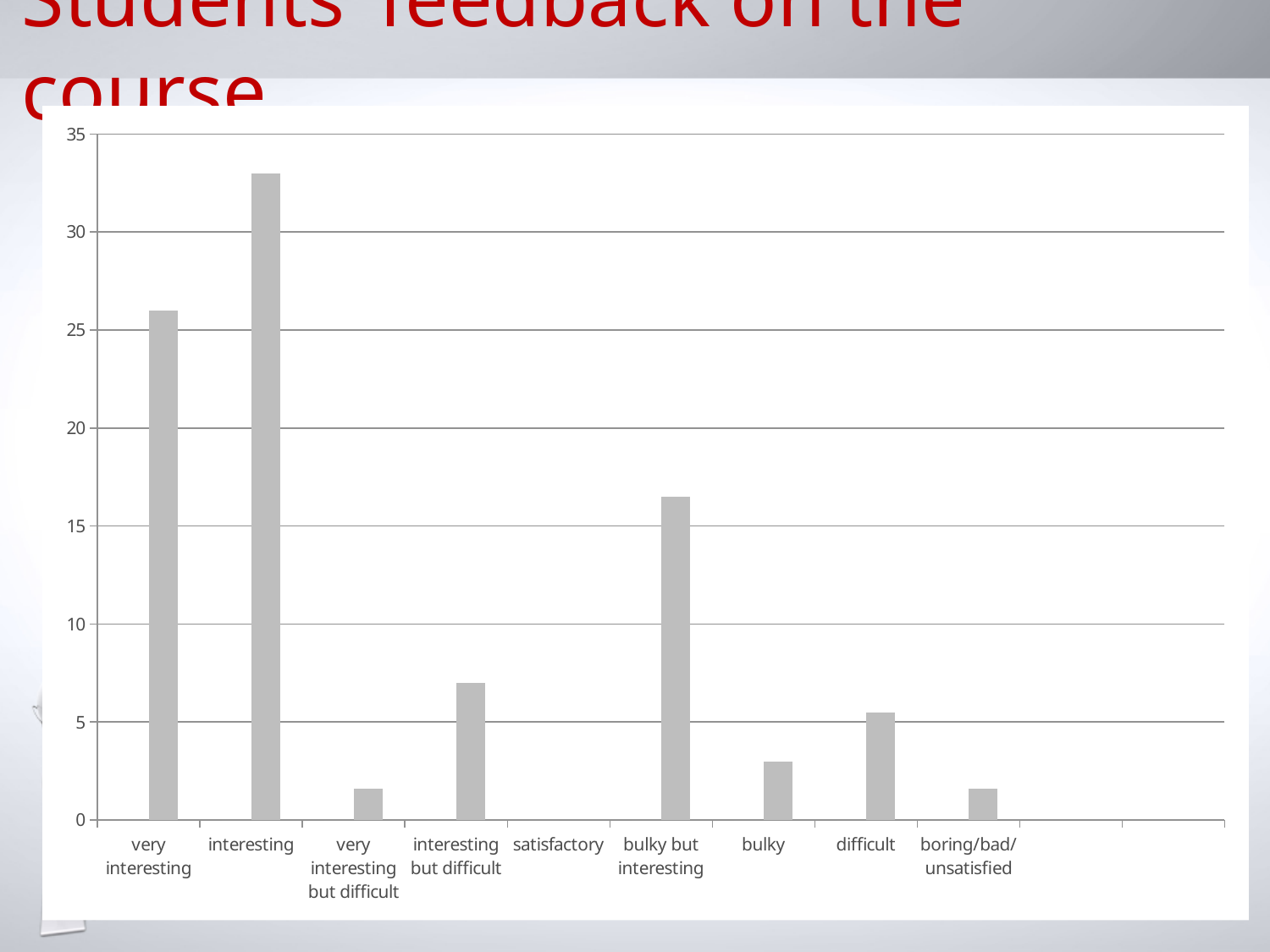
What is the title of the slide containing the chart? Students' feedback on the course Which is larger, the value for 'interesting but difficult' or the value for 'difficult'? interesting but difficult Is the value for 'bulky' greater or less than 5? less Is the value for 'interesting' greater or less than 30? greater Which is larger, the value for 'interesting' or the value for 'very interesting'? interesting Is the value for 'very interesting' greater or less than 25? greater Which category has the highest value? interesting Which is larger, the value for 'very interesting' or the value for 'bulky but interesting'? very interesting What kind of chart is shown on the slide? bar chart